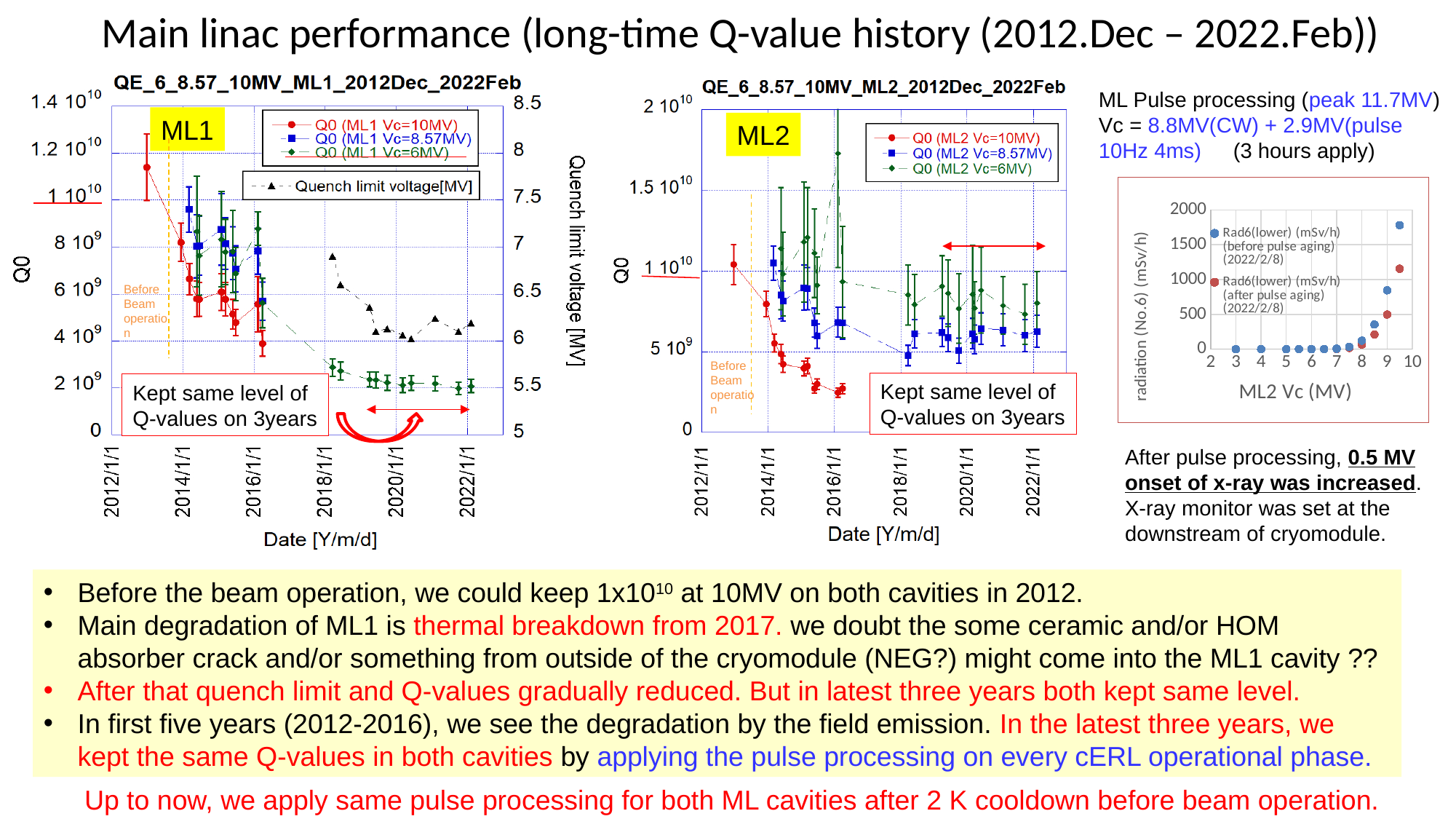
In the ML1 chart (left), what is the label of the right-hand y axis? Quench limit voltage [MV] In the radiation chart on the right, at the highest ML2 Vc plotted, which series has the larger radiation value: before pulse aging or after pulse aging? before pulse aging In the ML2 chart (middle), around 2020/1/1, which series has the larger Q0: Q0 (ML2 Vc=6MV) or Q0 (ML2 Vc=8.57MV)? Q0 (ML2 Vc=6MV) In the ML1 chart (left), is the Q0 (ML1 Vc=6MV) value around 2020/1/1 greater or less than 4 10^9? less In the ML2 chart (middle), is the Q0 (ML2 Vc=10MV) value around 2016/1/1 greater or less than 5 10^9? less In the ML1 chart (left), do the Q0 (ML1 Vc=6MV) values rise or fall from 2014 to 2022? fall How many series does the legend of the ML1 chart (left) list? 4 In the ML2 chart (middle), do the Q0 (ML2 Vc=10MV) values rise or fall from 2012 to 2016? fall How many series does the legend of the ML2 chart (middle) list? 3 In the ML1 chart (left), is the Quench limit voltage around 2022/1/1 greater or less than 6.5 MV? less What kind of chart is the left chart titled QE_6_8.57_10MV_ML1_2012Dec_2022Feb? scatter (line) chart In the ML1 chart (left), what is the x-axis label? Date [Y/m/d]